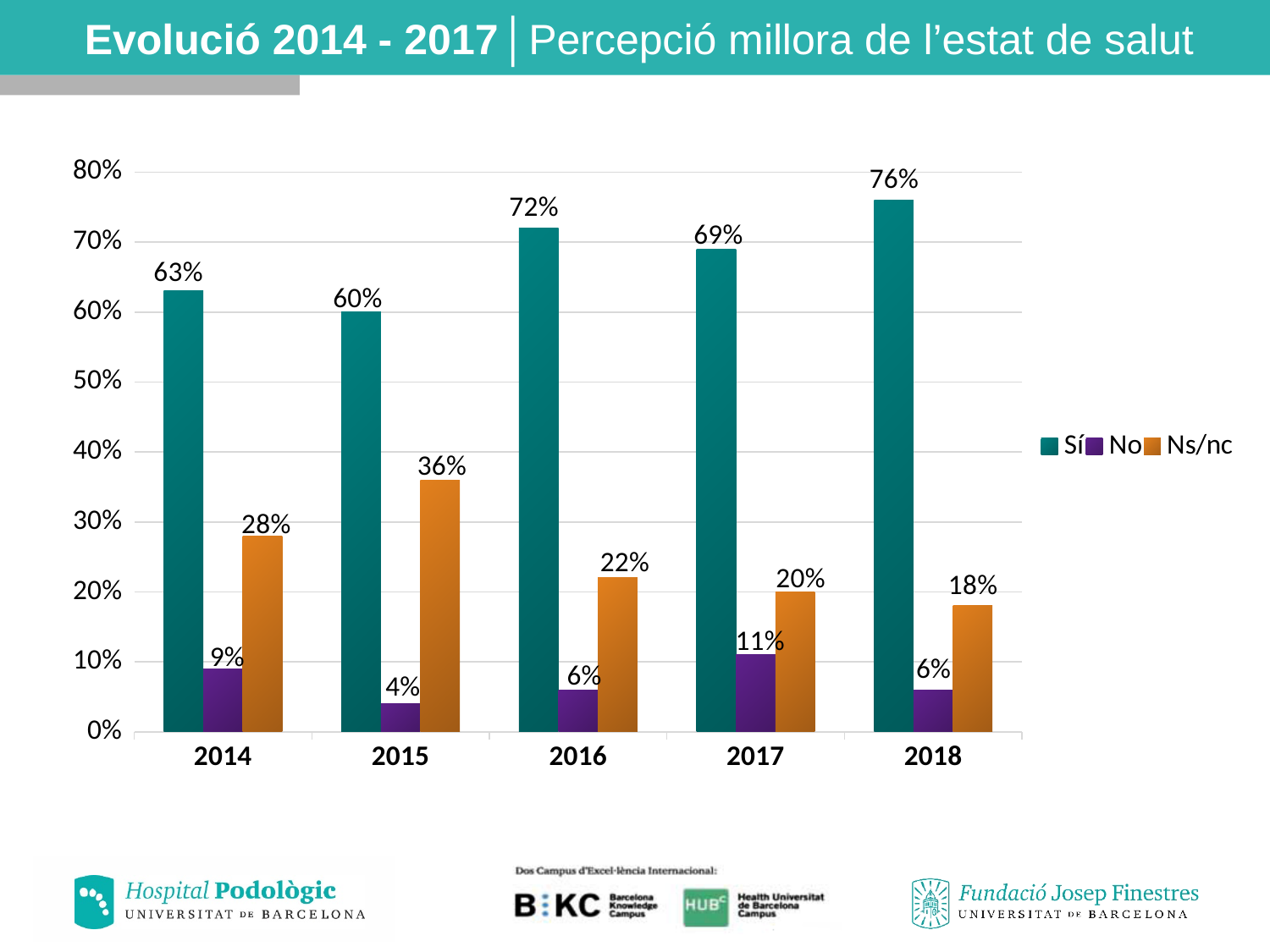
Which is larger: the Ns/nc value for 2014 or the Ns/nc value for 2016? 2014 What is the value of the No series for 2017? 11% In which year is the Sí series highest? 2018 How many years are shown on the x axis? 5 How many series does the legend list? 3 What is the value of the Ns/nc series for 2015? 36% What is the value of the Sí series for 2016? 72% What is the difference between the Sí values for 2018 and 2014? 13% Which series is shown in orange in the legend? Ns/nc Does the Ns/nc series rise or fall from 2015 to 2018? fall In which year is the No series lowest? 2015 What kind of chart is shown on the slide? bar chart